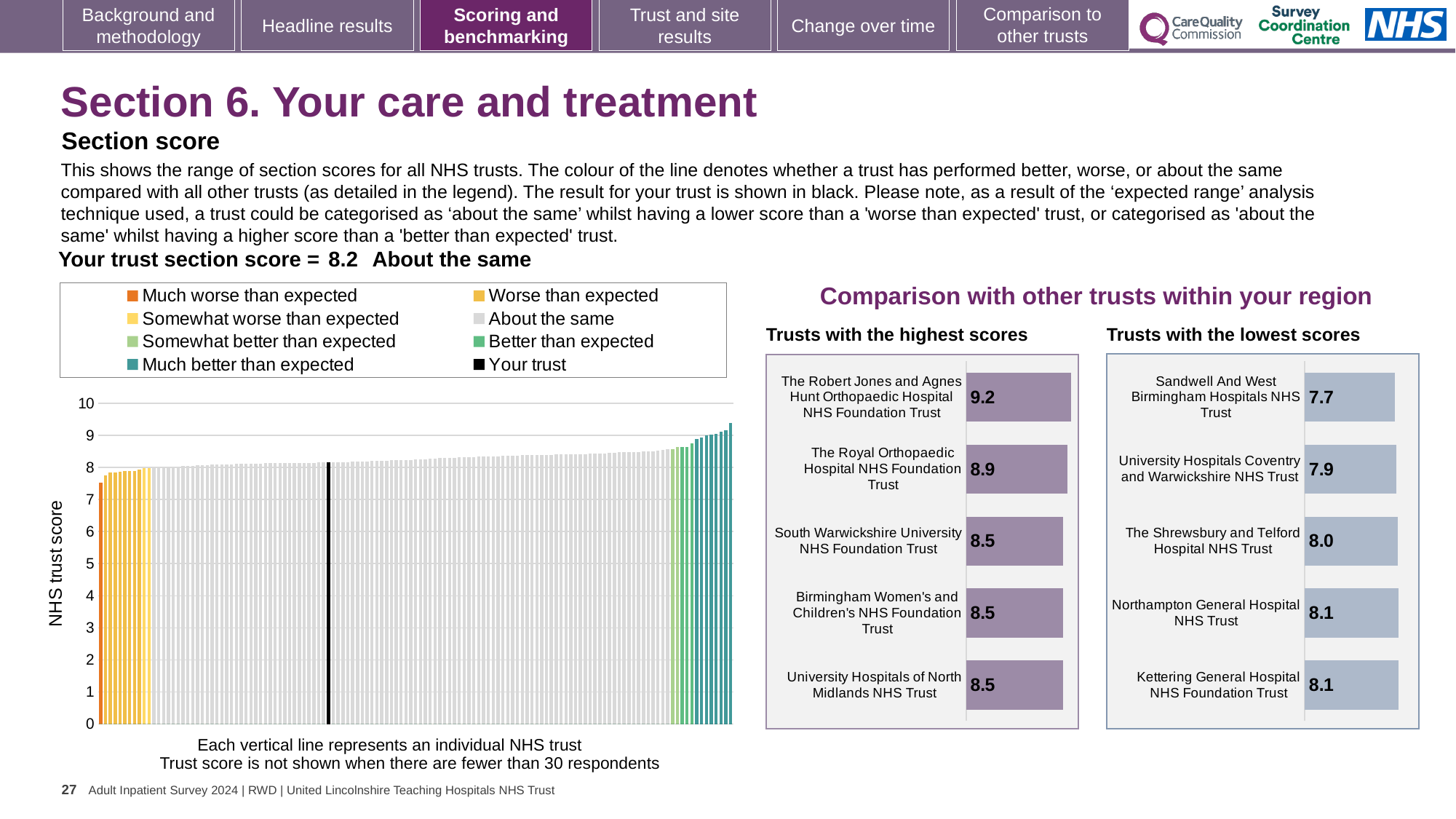
In the 'Trusts with the highest scores' chart, what is the score for The Robert Jones and Agnes Hunt Orthopaedic Hospital NHS Foundation Trust? 9.2 In the main NHS trust score chart on the left, is the value of the lowest (leftmost) bar greater or less than 8? less In the 'Trusts with the lowest scores' chart, what is the difference between the scores of Kettering General Hospital NHS Foundation Trust and Sandwell And West Birmingham Hospitals NHS Trust? 0.4 In the 'Trusts with the highest scores' chart, which trust has the highest score? The Robert Jones and Agnes Hunt Orthopaedic Hospital NHS Foundation Trust In the 'Trusts with the lowest scores' chart, what is the score for Sandwell And West Birmingham Hospitals NHS Trust? 7.7 In the 'Trusts with the lowest scores' chart, which has the higher score: The Shrewsbury and Telford Hospital NHS Trust or University Hospitals Coventry and Warwickshire NHS Trust? The Shrewsbury and Telford Hospital NHS Trust In the main NHS trust score chart on the left, is the value of the highest (rightmost) bar greater or less than 9? greater In the 'Trusts with the lowest scores' chart, which trust has the lowest score? Sandwell And West Birmingham Hospitals NHS Trust In the 'Trusts with the highest scores' chart, what is the difference between the scores of The Robert Jones and Agnes Hunt Orthopaedic Hospital NHS Foundation Trust and The Royal Orthopaedic Hospital NHS Foundation Trust? 0.3 What kind of chart is the main chart showing NHS trust scores on the left of the slide? Bar chart How many entries does the legend of the main NHS trust score chart list? 8 How many trusts are shown in the 'Trusts with the highest scores' chart? 5